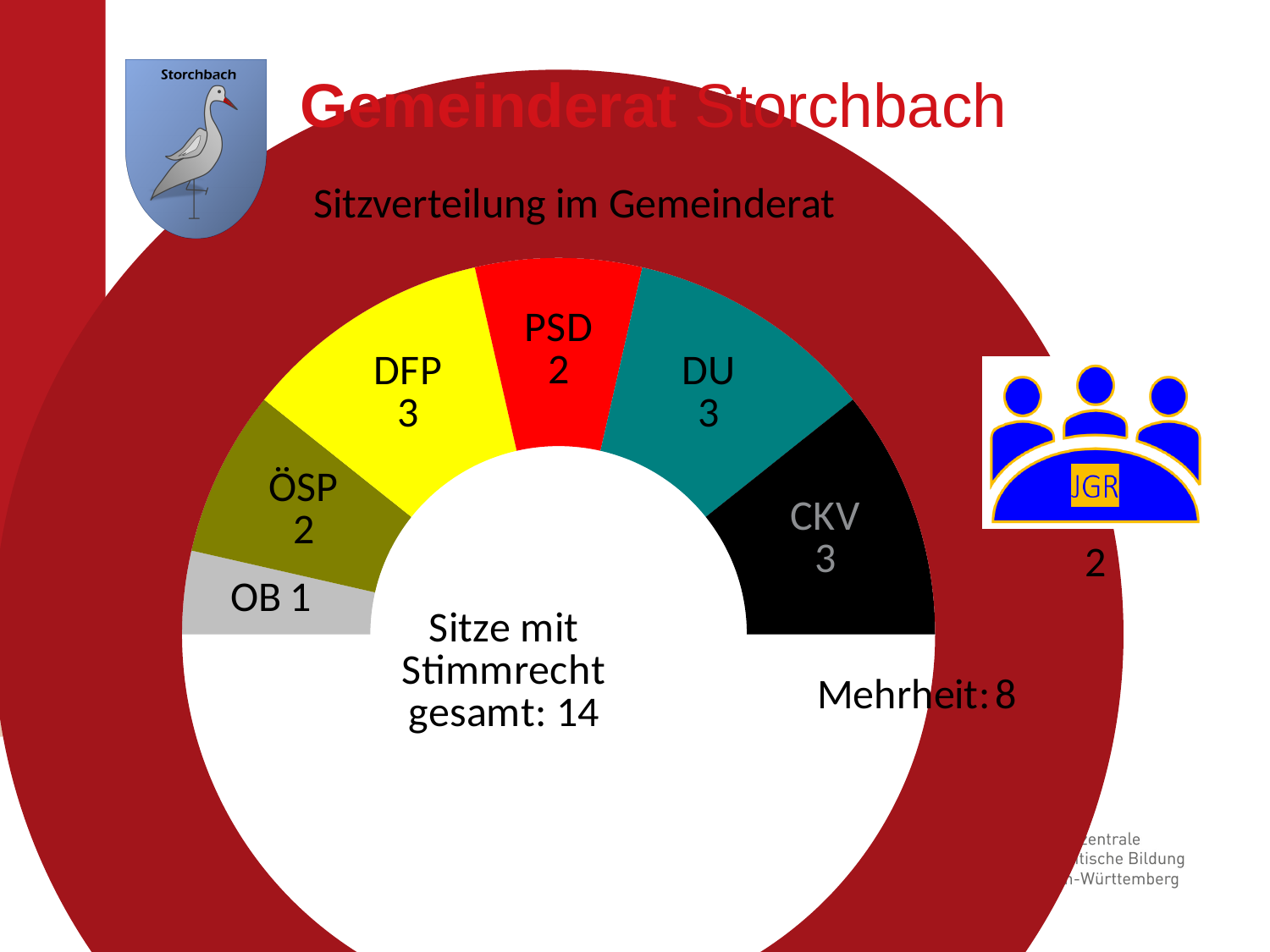
How many seats does OB have? 1 What is the title of the chart? Sitzverteilung im Gemeinderat How many seats does ÖSP have? 2 Which party has the fewest seats in the chart? OB What is the difference in seats between DU and PSD? 1 How many parties are shown in the seat distribution chart? 6 What kind of chart is used to show the seat distribution? Doughnut chart (half-circle) What colour is the PSD segment? Red Which has more seats, DFP or ÖSP? DFP What is the total number of seats with voting rights shown in the chart? 14 How many seats does DFP have in the Gemeinderat? 3 How many seats does CKV have? 3